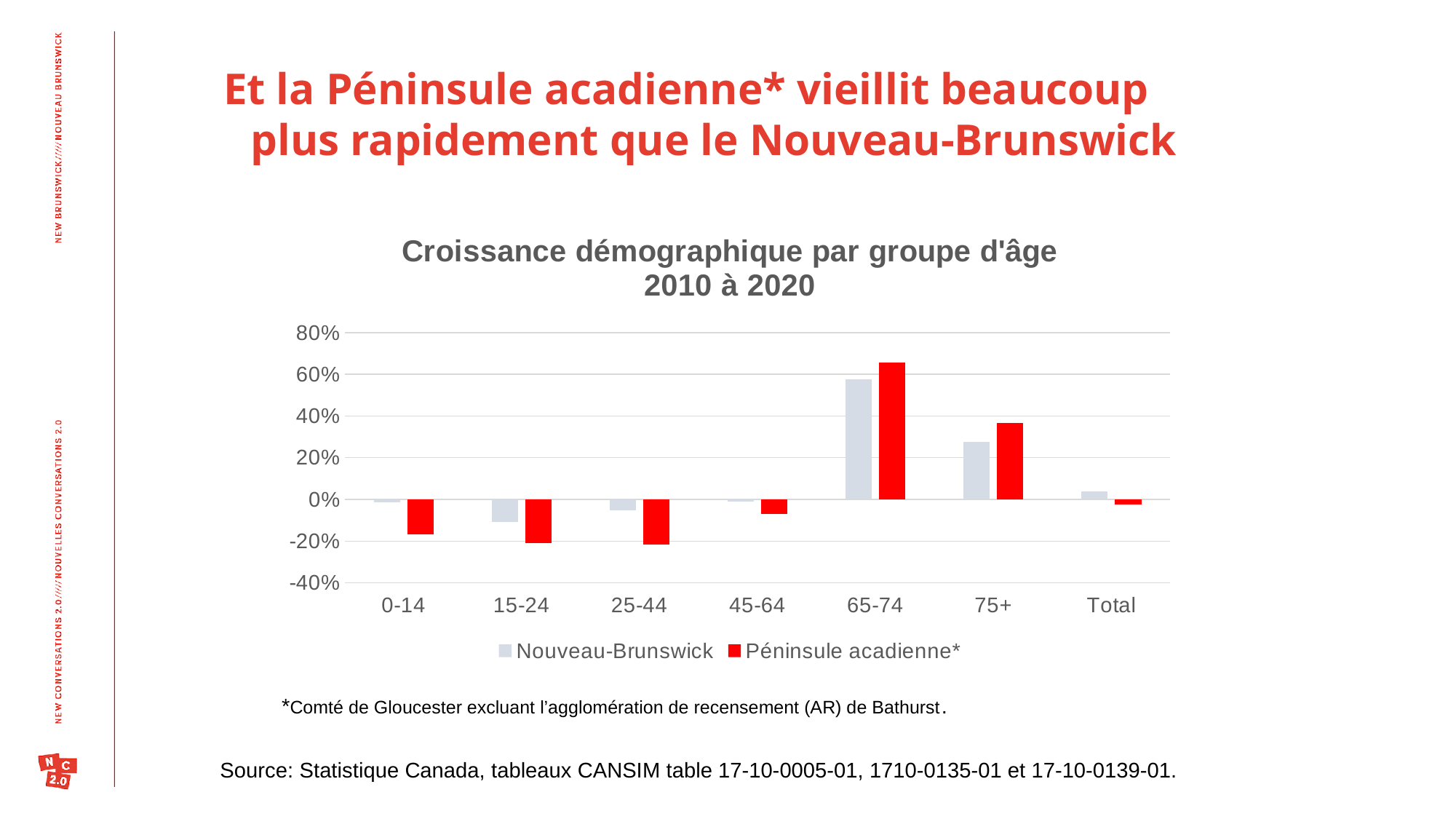
How many series does the chart legend list? 2 For the 0-14 group, which series has the larger value: Nouveau-Brunswick or Péninsule acadienne*? Nouveau-Brunswick Is the value for Péninsule acadienne* in the 0-14 group greater or less than 0%? less How many age-group categories are shown on the x axis of the chart? 7 Which category has the highest value for Péninsule acadienne*? 65-74 For the 65-74 group, which series has the larger value: Nouveau-Brunswick or Péninsule acadienne*? Péninsule acadienne* Which category has the lowest value for Nouveau-Brunswick? 15-24 Is the value for Nouveau-Brunswick in the 75+ group greater or less than 20%? greater Which category has the highest value for Nouveau-Brunswick? 65-74 What kind of chart is shown on the slide? bar chart What is the title of the chart? Croissance démographique par groupe d'âge 2010 à 2020 Is the value for Péninsule acadienne* in the 65-74 group greater or less than 60%? greater